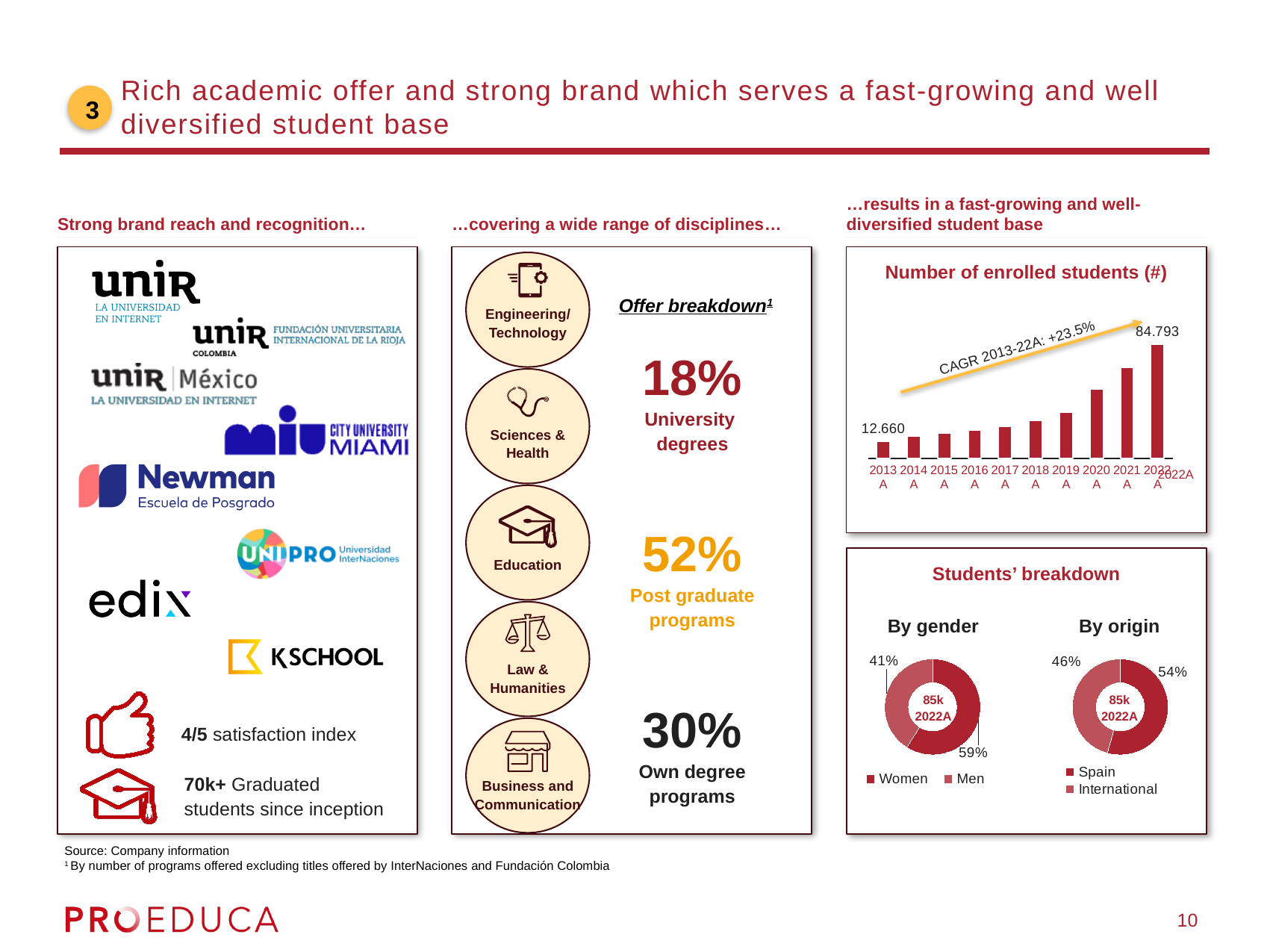
How many entries does the legend of the 'By gender' chart list? 2 What kind of chart is the 'Number of enrolled students (#)' chart? bar chart How many years are shown on the x axis of the 'Number of enrolled students (#)' chart? 10 In the 'Number of enrolled students (#)' chart, is the value for 2021A larger or smaller than the value for 2020A? larger Do the values in the 'Number of enrolled students (#)' chart rise or fall from 2013A to 2022A? rise In the 'Number of enrolled students (#)' chart, what is the value for 2022A? 84.793 What kind of charts are used in the 'Students' breakdown' section? pie (donut) charts In the 'Number of enrolled students (#)' chart, which year has the lowest number of enrolled students? 2013A What CAGR for 2013-22A is annotated on the 'Number of enrolled students (#)' chart? +23.5% What total is shown in the centre of the 'By origin' donut chart? 85k 2022A In the 'Number of enrolled students (#)' chart, what is the value for 2013A? 12.660 In the 'Number of enrolled students (#)' chart, which year has the highest number of enrolled students? 2022A